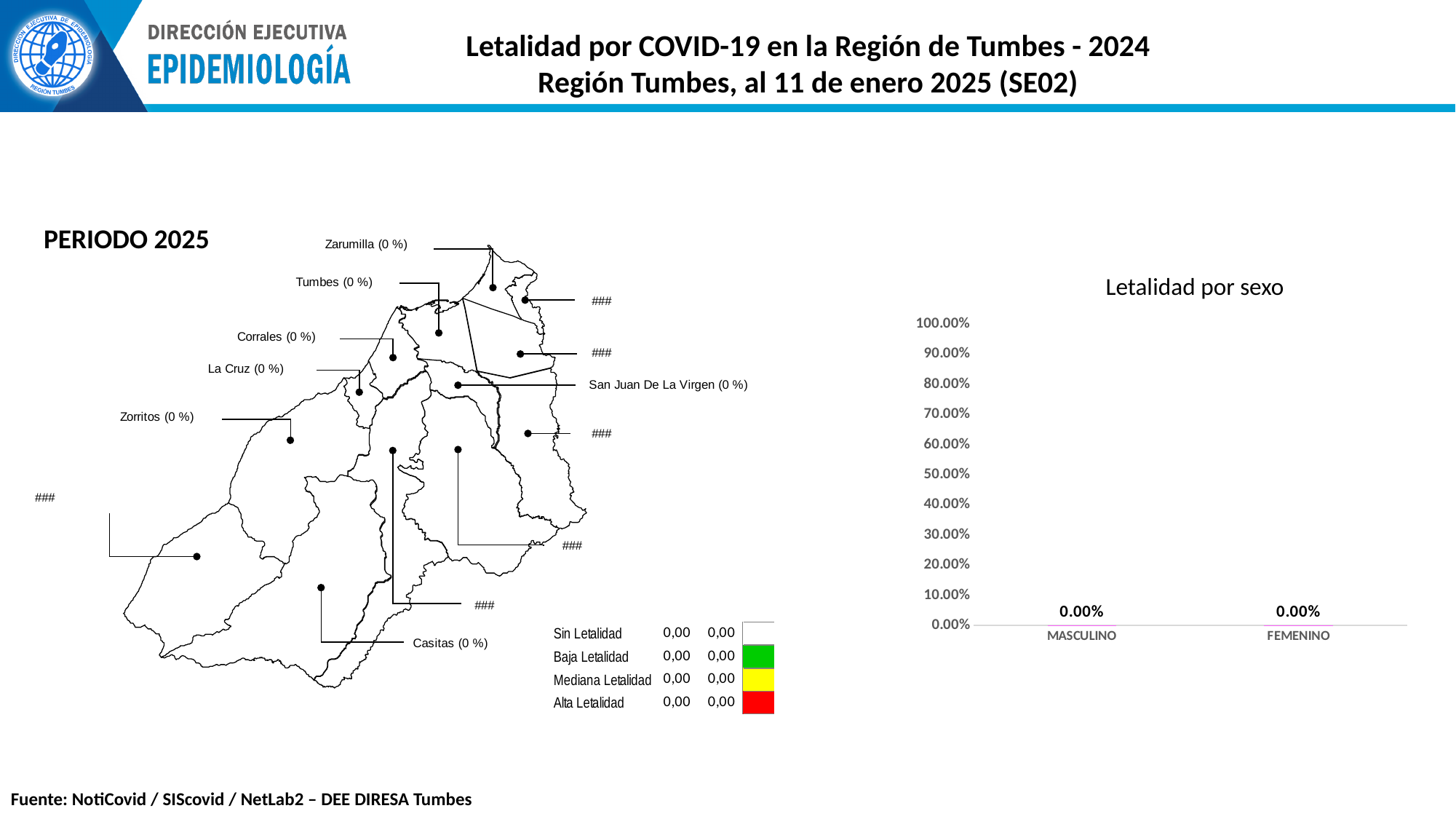
What is the title of the chart on the right side of the slide? Letalidad por sexo On the map on the left, what letalidad value is shown for Zarumilla? 0 % In the 'Letalidad por sexo' chart, what is the highest value shown on the y axis? 100.00% In the 'Letalidad por sexo' chart, how many categories are shown on the x axis? 2 In the 'Letalidad por sexo' chart, is the value for MASCULINO greater or less than 50.00%? less On the map on the left, what letalidad value is shown for Casitas? 0 % In the 'Letalidad por sexo' chart, what is the value for MASCULINO? 0.00% On the map on the left, what letalidad value is shown for San Juan De La Virgen? 0 % In the 'Letalidad por sexo' chart, what is the value for FEMENINO? 0.00% In the 'Letalidad por sexo' chart, is the value for FEMENINO greater or less than 10.00%? less In the 'Letalidad por sexo' chart, what is the difference between the MASCULINO and FEMENINO values? 0.00%